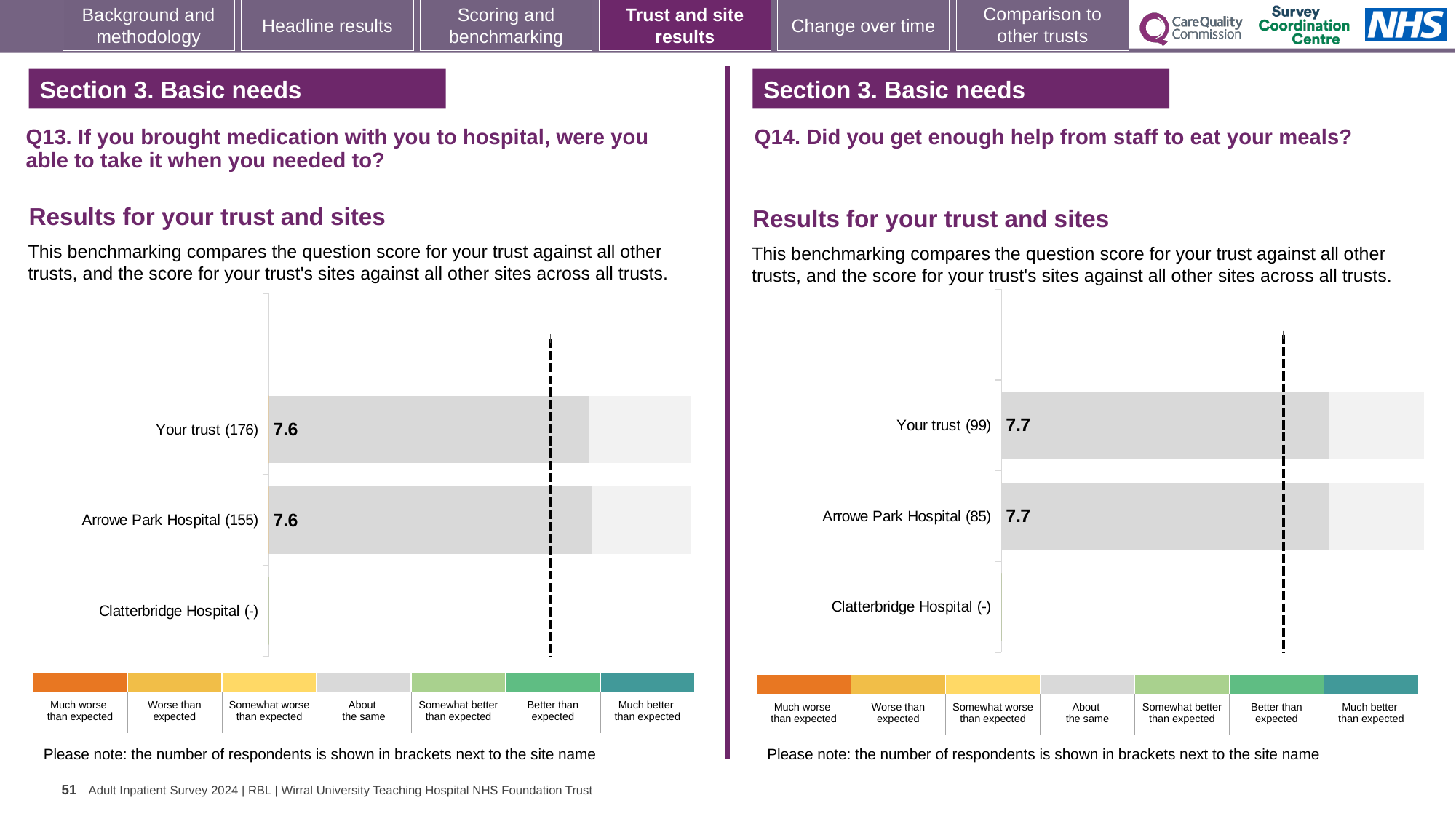
In the Q14 chart on the right, what is the score for Arrowe Park Hospital? 7.7 In the Q13 chart on the left, what is the score for Your trust? 7.6 In the Q13 chart on the left, what is the difference between the scores for Your trust and Arrowe Park Hospital? 0 How many site or trust categories are listed on the y axis of the Q13 chart on the left? 3 How many site or trust categories are listed on the y axis of the Q14 chart on the right? 3 What kind of chart is used for the Q13 results on the left? Bar chart In the Q13 chart on the left, how many respondents are shown in brackets for Your trust? 176 In the Q14 chart on the right, what is the difference between the scores for Your trust and Arrowe Park Hospital? 0 In the Q14 chart on the right, how many respondents are shown in brackets for Arrowe Park Hospital? 85 In the Q14 chart on the right, what is the score for Your trust? 7.7 In the Q14 chart on the right, which category has no score shown? Clatterbridge Hospital In the Q13 chart on the left, what is the score for Arrowe Park Hospital? 7.6